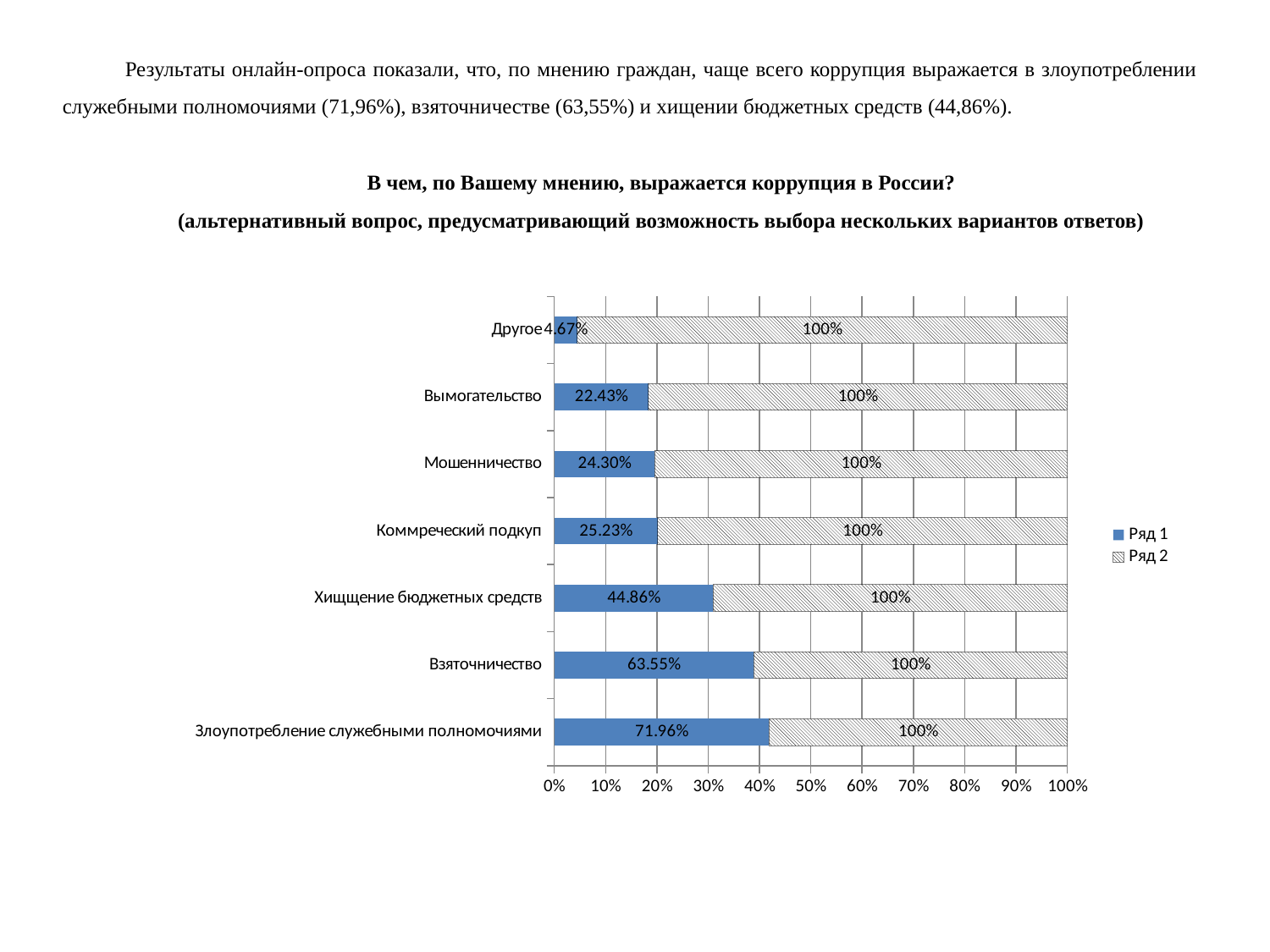
What is the Ряд 1 value for Другое? 4.67% What kind of chart is shown on the slide? Bar chart Which category has the highest Ряд 1 value? Злоупотребление служебными полномочиями How many categories are shown on the chart? 7 How many series does the legend list? 2 Which has a larger Ряд 1 value, Вымогательство or Хищение бюджетных средств? Хищение бюджетных средств Which category has the lowest Ряд 1 value? Другое What is the difference between the Ряд 1 values for Взяточничество and Хищение бюджетных средств? 18.69% What is the Ряд 1 value for Взяточничество? 63.55% What is the difference between the Ряд 1 values for Злоупотребление служебными полномочиями and Взяточничество? 8.41% What is the Ряд 1 value for Мошенничество? 24.30% What is the Ряд 1 value for Хищение бюджетных средств? 44.86%